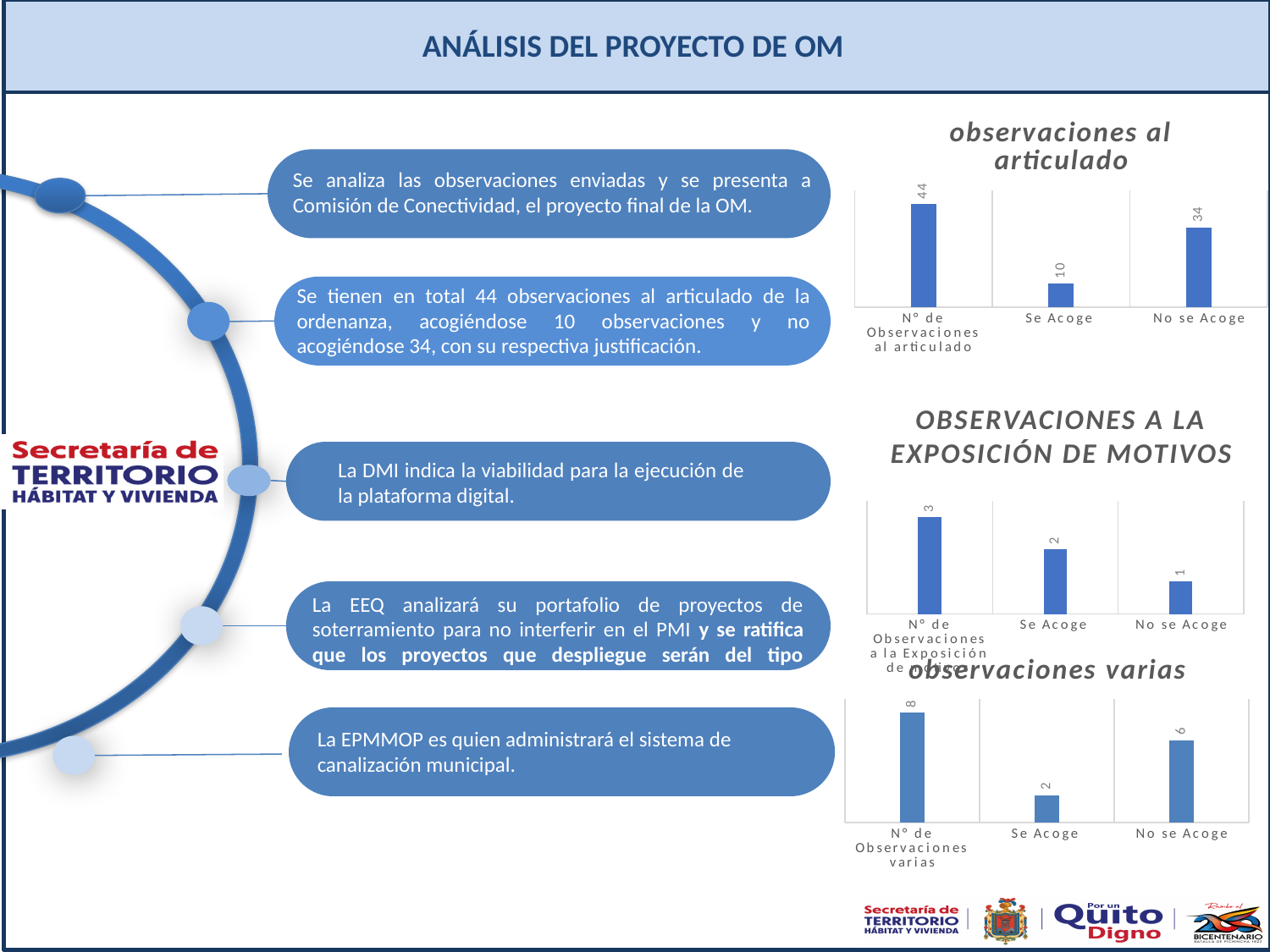
In the 'OBSERVACIONES A LA EXPOSICIÓN DE MOTIVOS' chart, which category has the lowest value? No se Acoge In the 'OBSERVACIONES A LA EXPOSICIÓN DE MOTIVOS' chart, what is the value for 'Se Acoge'? 2 In the 'observaciones al articulado' chart, what is the difference between 'No se Acoge' and 'Se Acoge'? 24 In the 'observaciones varias' chart, what is the difference between 'No se Acoge' and 'Se Acoge'? 4 In the 'OBSERVACIONES A LA EXPOSICIÓN DE MOTIVOS' chart, which is larger, 'Se Acoge' or 'No se Acoge'? Se Acoge In the 'observaciones varias' chart, what is the value for 'No se Acoge'? 6 In the 'observaciones al articulado' chart, what is the value for 'Se Acoge'? 10 What type of chart is the 'observaciones al articulado' chart? Bar chart In the 'observaciones al articulado' chart, which category has the highest value? N° de Observaciones al articulado In the 'observaciones varias' chart, what is the value for 'N° de Observaciones varias'? 8 How many categories are shown in the 'observaciones varias' chart? 3 In the 'observaciones al articulado' chart, what is the value for 'No se Acoge'? 34